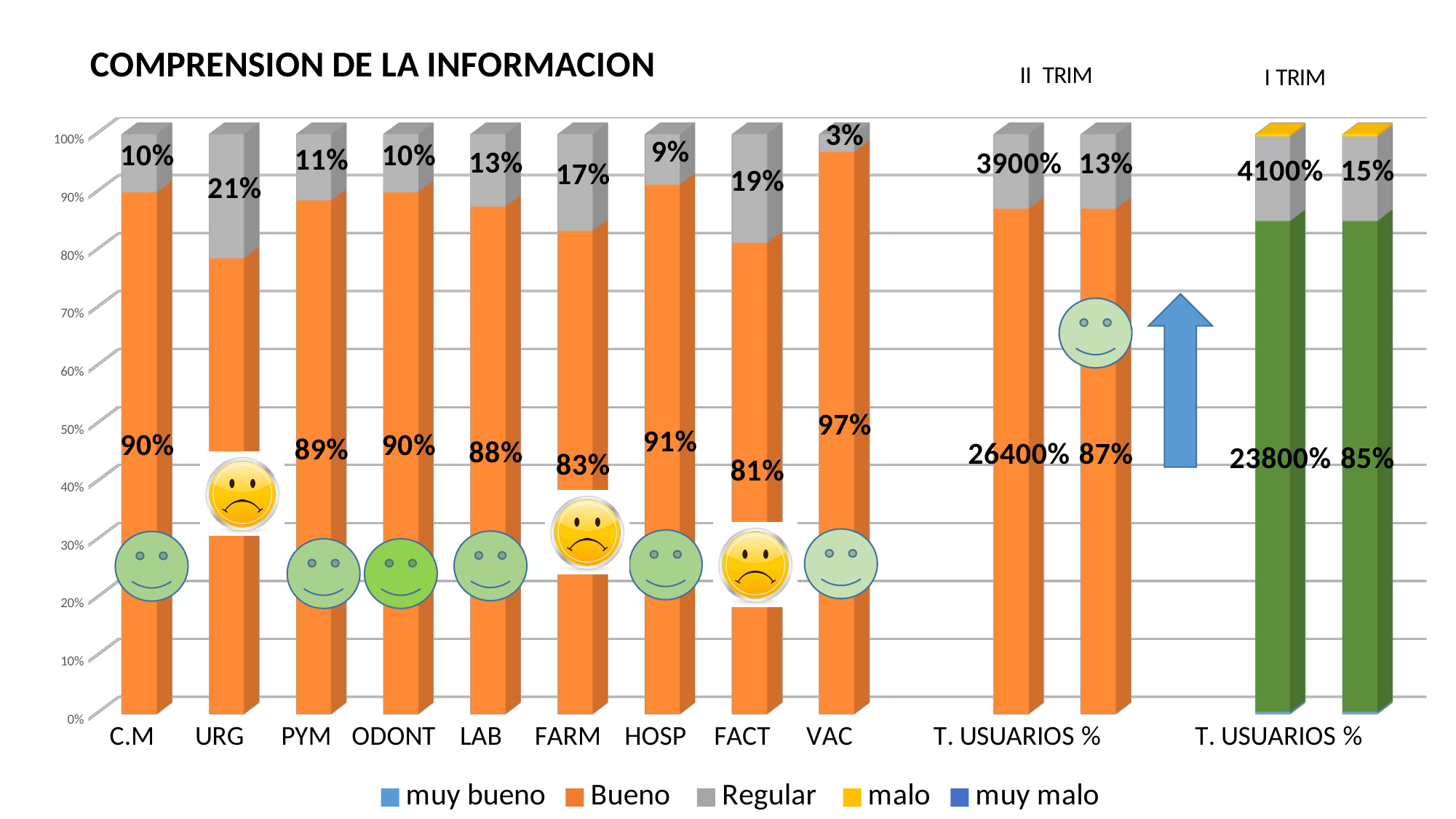
What is the Regular value for URG? 21% What is the difference between the Bueno values for VAC and FACT? 16% What is the Bueno value for FACT? 81% What type of chart is shown on the slide? bar chart What is the title of the chart? COMPRENSION DE LA INFORMACION What is the Regular value for HOSP? 9% Which category has the highest Bueno value among the department bars (C.M to VAC)? VAC What is the Bueno value for VAC? 97% Which category has the lowest Regular value? VAC How many series does the legend list? 5 Which has a larger Regular value, FARM or LAB? FARM